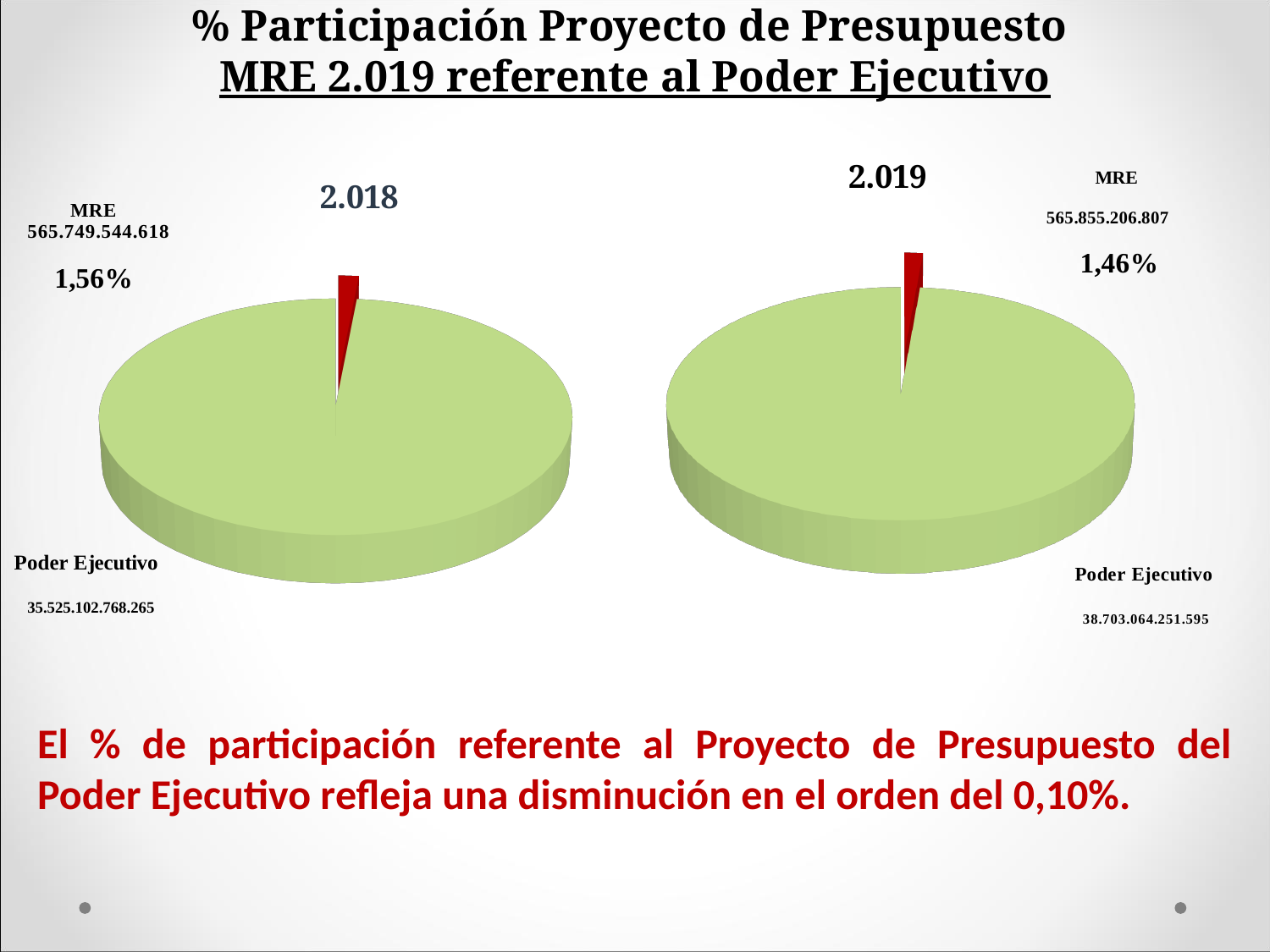
In the 2.019 pie chart, which slice is larger, MRE or Poder Ejecutivo? Poder Ejecutivo In the 2.018 pie chart, what value is shown for MRE? 565.749.544.618 In the 2.018 pie chart, what share of the pie does MRE represent? 1,56% What kind of chart is used for the 2.018 and 2.019 data on this slide? Pie chart In the 2.019 pie chart, what share of the pie does MRE represent? 1,46% What is the difference between the MRE share in the 2.018 pie chart and the MRE share in the 2.019 pie chart? 0,10% How many slices does the 2.019 pie chart have? 2 In the 2.018 pie chart, what colour is the MRE slice? Red In the 2.019 pie chart, what value is shown for Poder Ejecutivo? 38.703.064.251.595 In the 2.019 pie chart, what value is shown for MRE? 565.855.206.807 In the 2.018 pie chart, what value is shown for Poder Ejecutivo? 35.525.102.768.265 Which pie chart shows the larger MRE share, 2.018 or 2.019? 2.018